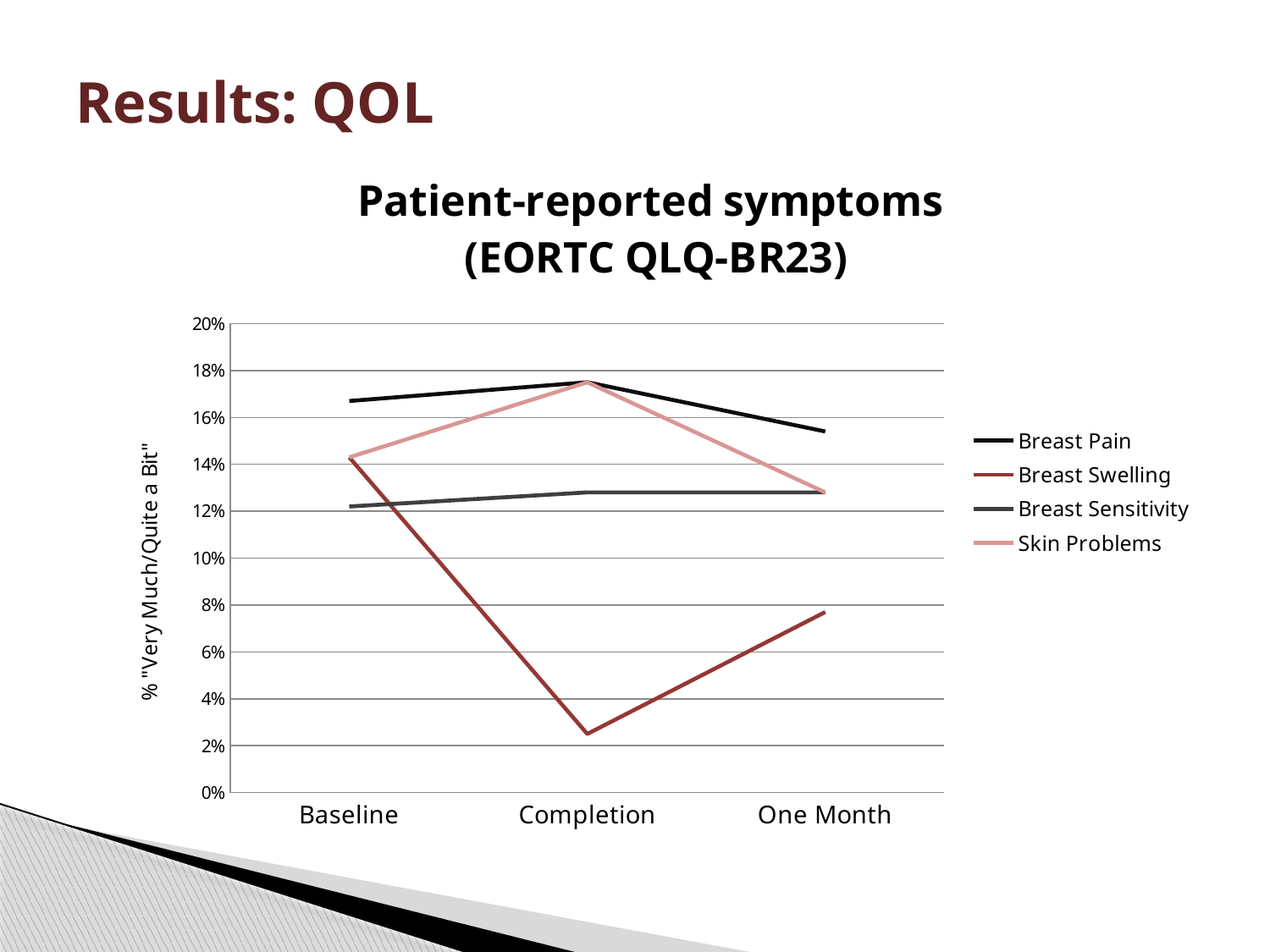
Is the value for Breast Sensitivity at Baseline greater or less than 14%? less Which series has the highest value at Baseline? Breast Pain Which series has the lowest value at One Month? Breast Swelling Is the value for Breast Pain at Baseline greater or less than 14%? greater For Breast Swelling, which is larger: the value at Baseline or the value at One Month? Baseline Does the Breast Swelling line rise or fall from Baseline to Completion? fall What is the label on the y axis? % "Very Much/Quite a Bit" How many series does the legend list? 4 How many time points are shown on the x axis? 3 Is the value for Breast Swelling at Completion greater or less than 4%? less Which series has the lowest value at Completion? Breast Swelling What kind of chart is shown on the slide? line chart